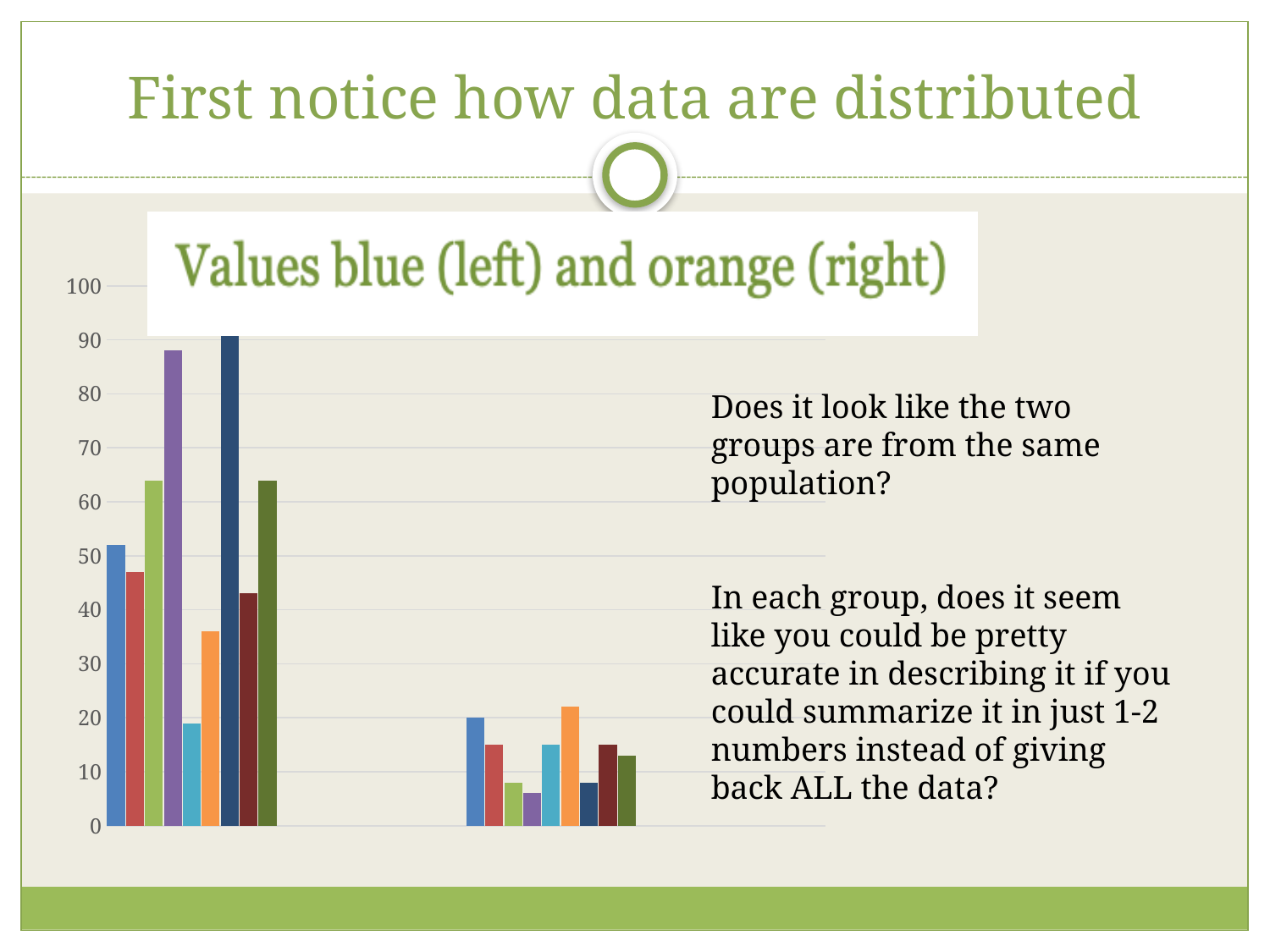
How many bars are in the left group of the chart? 9 Which bar in the left group is the tallest: the purple bar or the dark navy bar? the dark navy bar Is the value of the purple bar in the right group greater or less than 10? less Is the value of the purple bar in the left group greater or less than 80? greater What kind of chart is shown on the slide? bar chart What is the highest value shown on the vertical axis of the chart? 100 What is the title of the chart? Values blue (left) and orange (right) Are all the bars in the right group greater or less than 30? less How many bars are in the right group of the chart? 9 How many bars are plotted in total on the chart? 18 Which group of bars, left or right, has the tallest bar? left